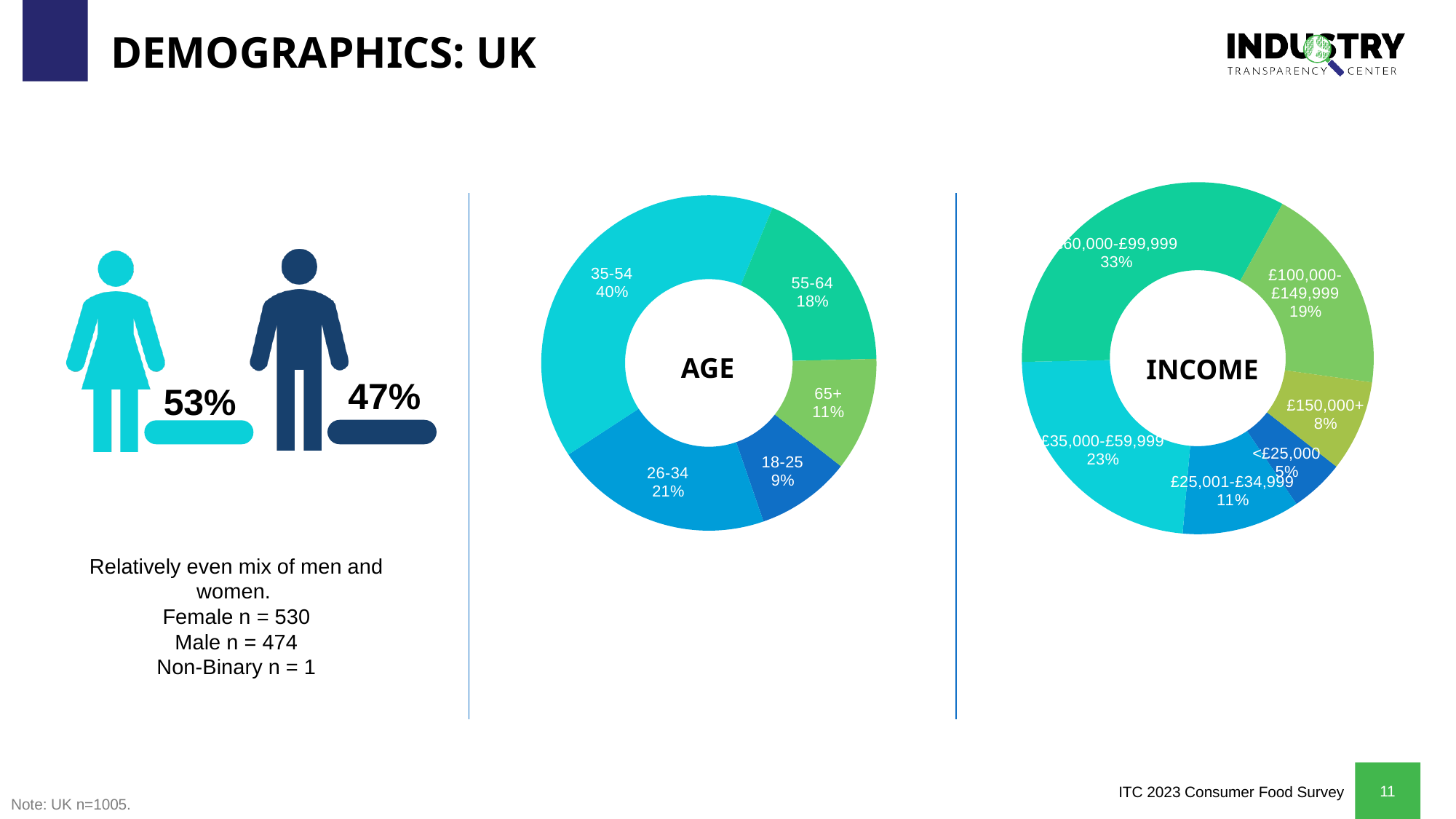
In the INCOME chart, which income band has the smallest share? <£25,000 In the AGE chart, which age group has the smallest share? 18-25 What type of chart is the AGE chart? Donut chart In the INCOME chart, what share of respondents earn £60,000-£99,999? 33% In the INCOME chart, what percentage of respondents earn £150,000+? 8% In the AGE chart, what percentage of respondents are aged 18-25? 9% In the AGE chart, what share of respondents are aged 35-54? 40% In the AGE chart, which age group has the largest share? 35-54 In the AGE chart, what is the difference in percentage points between the 26-34 and 55-64 groups? 3 How many age groups are shown in the AGE chart? 5 How many income bands are shown in the INCOME chart? 6 In the INCOME chart, which is larger: the share for £35,000-£59,999 or the share for £100,000-£149,999? £35,000-£59,999